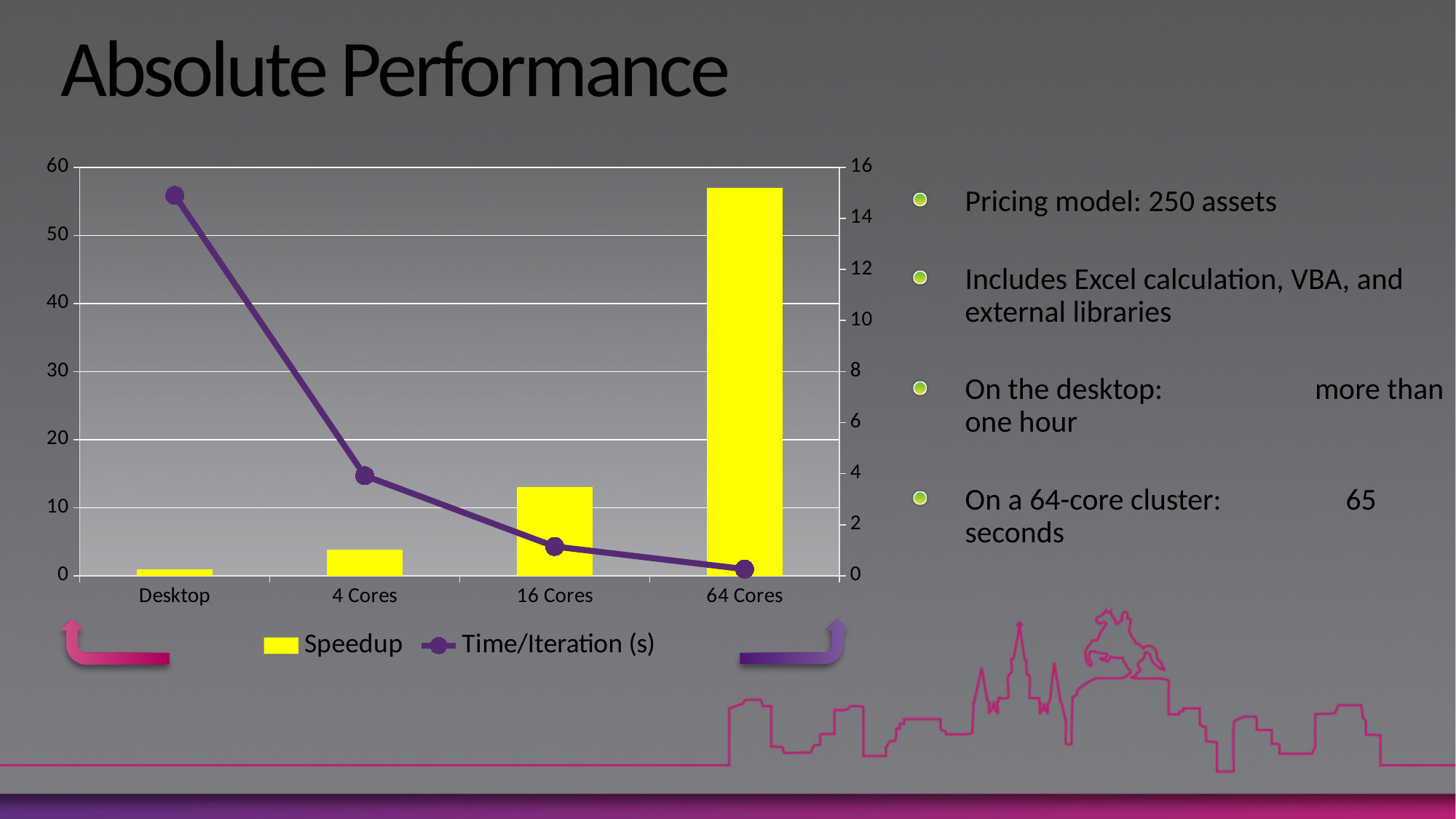
Is the Speedup value for 16 Cores greater or less than 10? greater What kind of chart is shown on the slide? A combined bar and line chart Which series is drawn as yellow bars in the chart? Speedup How many series does the chart legend list? 2 Which category has the lowest Speedup? Desktop Does the Time/Iteration (s) line rise or fall from Desktop to 64 Cores? It falls Which category has the highest Time/Iteration (s)? Desktop Which category has the highest Speedup? 64 Cores Is the Time/Iteration (s) value for 16 Cores greater or less than 2? less Is the Time/Iteration (s) value for Desktop greater or less than 14? greater How many categories are shown on the x axis of the chart? 4